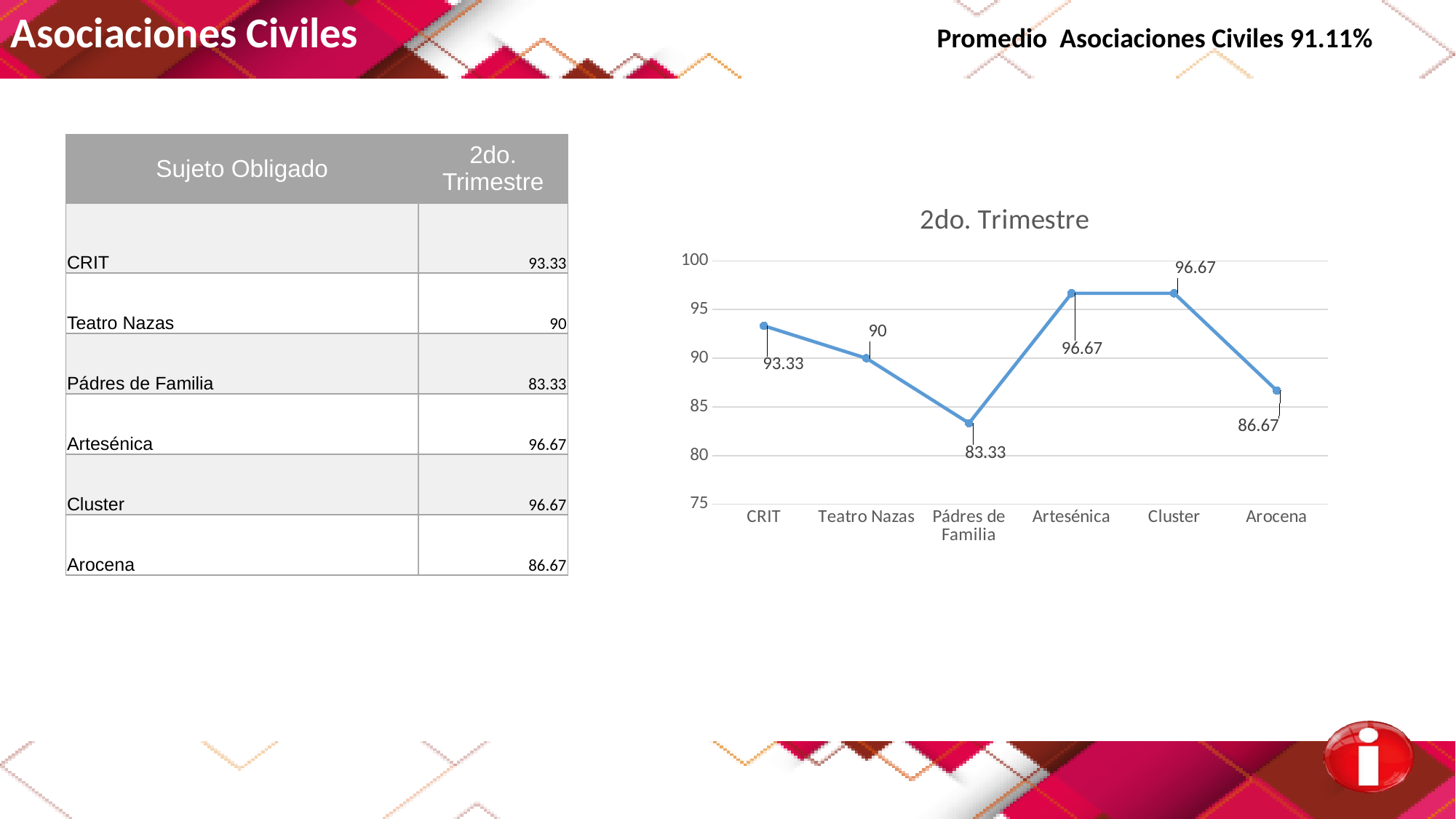
What is the value for Teatro Nazas in the chart? 90 What is the difference between the values for Artesénica and Pádres de Familia? 13.34 What is the value for Arocena in the chart? 86.67 What is the title of the chart? 2do. Trimestre How many categories are plotted on the x axis of the chart? 6 What is the value for Pádres de Familia in the chart? 83.33 Which is larger, the value for CRIT or the value for Arocena? CRIT Which category has the lowest value in the chart? Pádres de Familia Do the values rise or fall from Cluster to Arocena? fall What kind of chart is shown on the slide? line chart Is the value for Teatro Nazas greater or less than 95? less What is the value for CRIT in the chart? 93.33